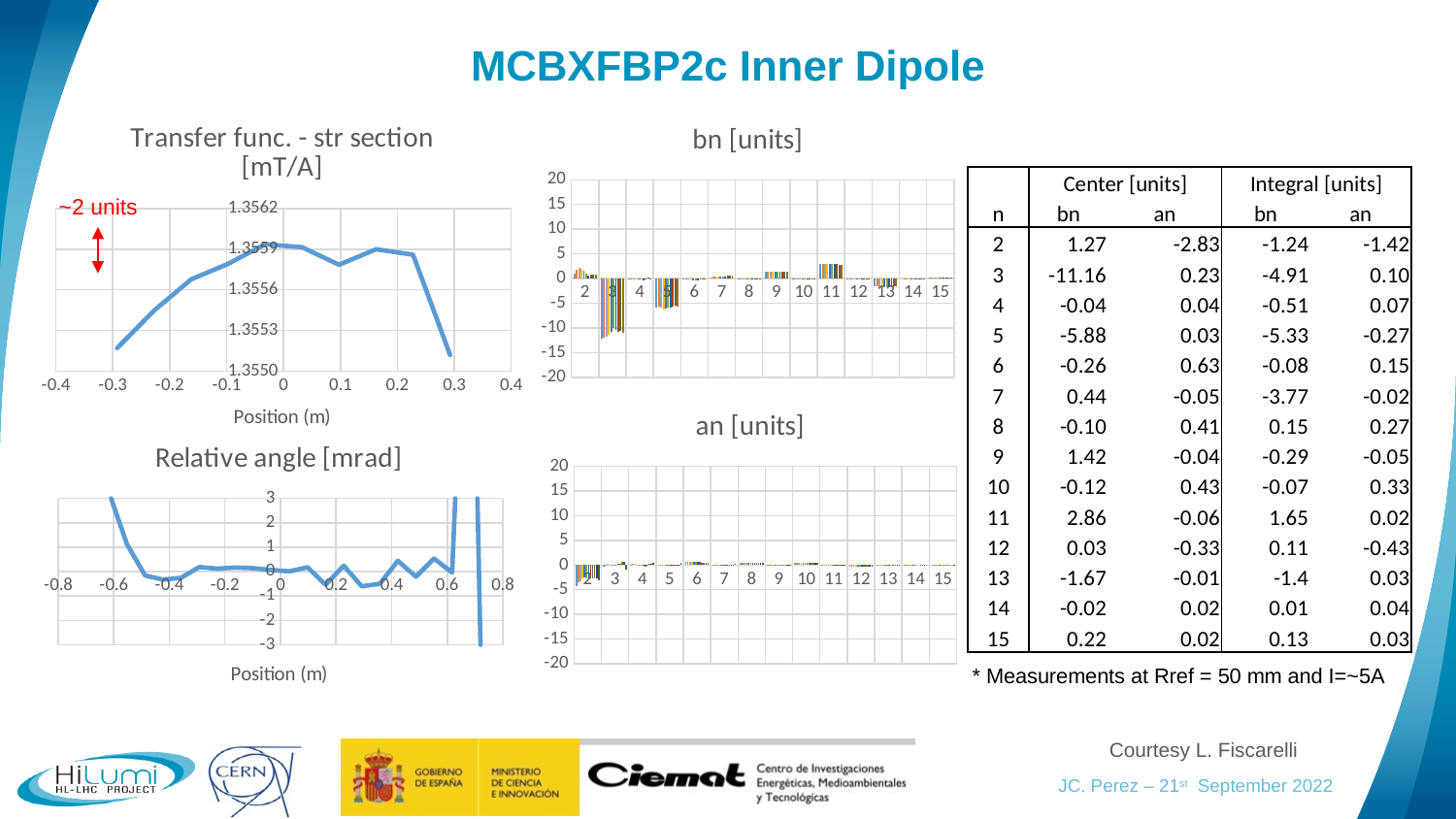
What is the maximum value shown on the y axis of the 'an [units]' chart? 20 In the 'Transfer func. - str section [mT/A]' chart, is the value at position 0.3 greater or less than 1.3553? less In the 'Transfer func. - str section [mT/A]' chart, is the value at position 0 greater or less than 1.3556? greater What kind of chart is the 'Transfer func. - str section [mT/A]' chart? line chart How many categories are shown on the x axis of the 'an [units]' chart? 14 In the 'Transfer func. - str section [mT/A]' chart, is the value at position -0.3 larger or smaller than the value at position 0.1? smaller What kind of chart is the 'bn [units]' chart? bar chart What is the x-axis label of the 'Relative angle [mrad]' chart? Position (m) In the 'bn [units]' chart, which category has the lowest (most negative) bars? 3 In the 'bn [units]' chart, are the bars for category 3 greater or less than -5? less How many categories are shown on the x axis of the 'bn [units]' chart? 14